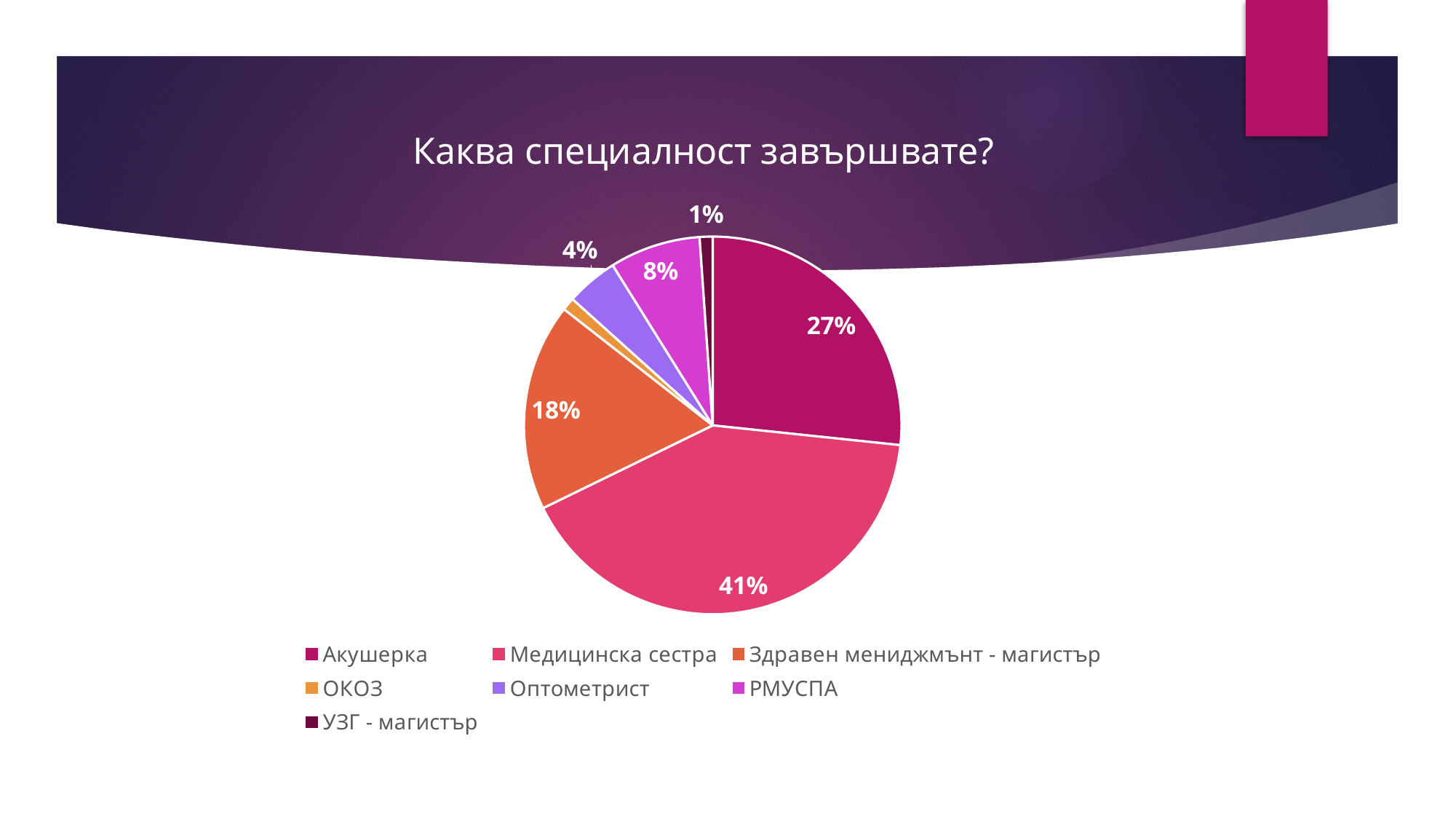
What is the difference between the shares of Медицинска сестра and Акушерка? 14% What share of the pie does Оптометрист have? 4% What share of the pie does РМУСПА have? 8% What share of the pie does Акушерка have? 27% How many categories does the legend list? 7 What is the title of the chart? Каква специалност завършвате? Which is larger, the share of Здравен мениджмънт - магистър or the share of РМУСПА? Здравен мениджмънт - магистър What type of chart is shown on the slide? pie chart Which category has the largest share of the pie? Медицинска сестра